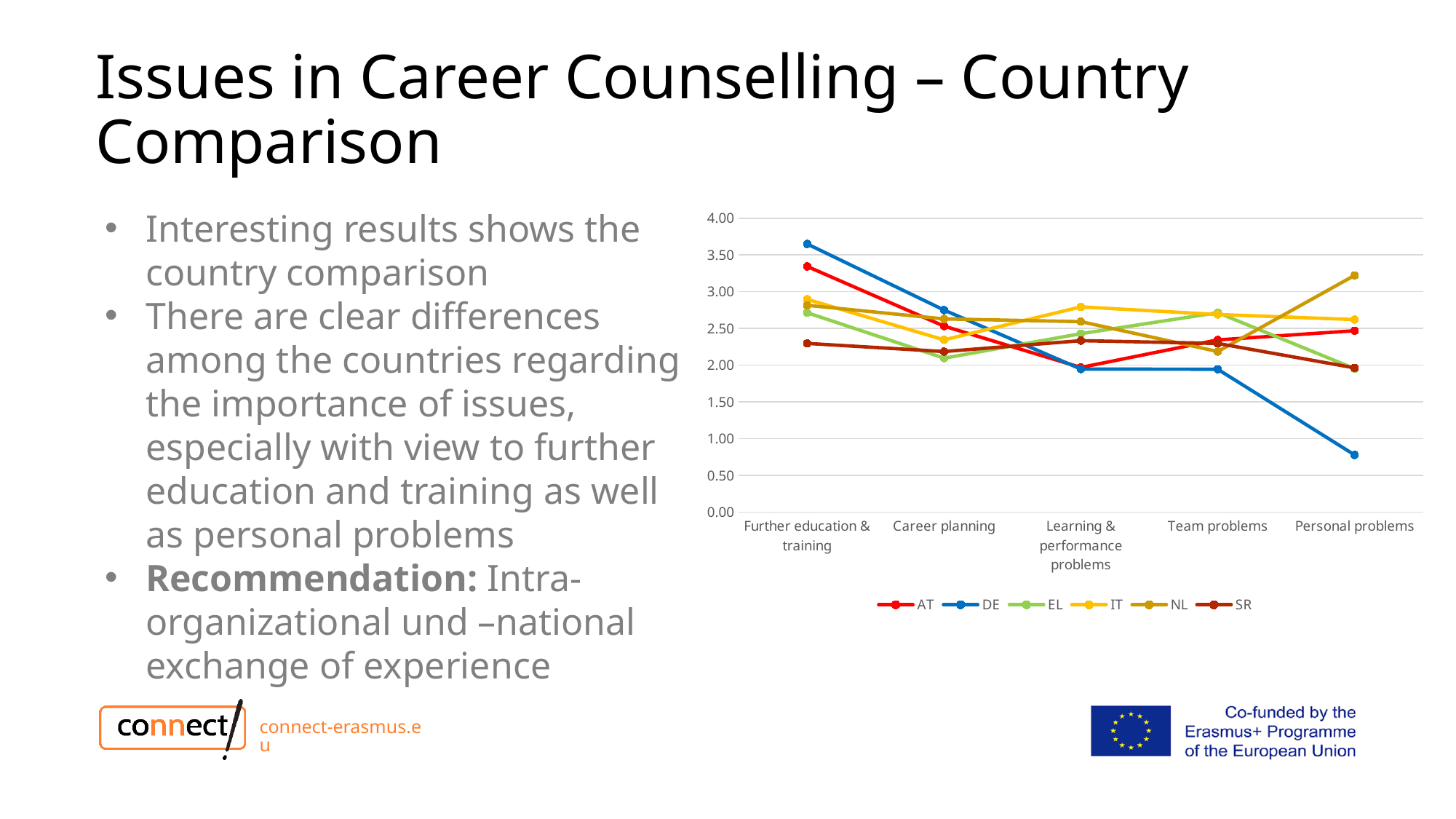
Is the value for DE at Personal problems greater or less than 1.00? less Which series has the lowest value for Further education & training? SR Which series has the highest value for Further education & training? DE How many categories are shown on the x axis of the chart? 5 How many series does the chart's legend list? 6 Does the DE series generally rise or fall from Further education & training to Personal problems? fall Is the value for NL at Personal problems greater or less than 3.00? greater Which is larger for Further education & training, the value for DE or the value for AT? DE Is the value for DE at Further education & training greater or less than 3.50? greater What kind of chart is shown on the slide? line chart Which series has the highest value for Personal problems? NL Which series has the lowest value for Personal problems? DE